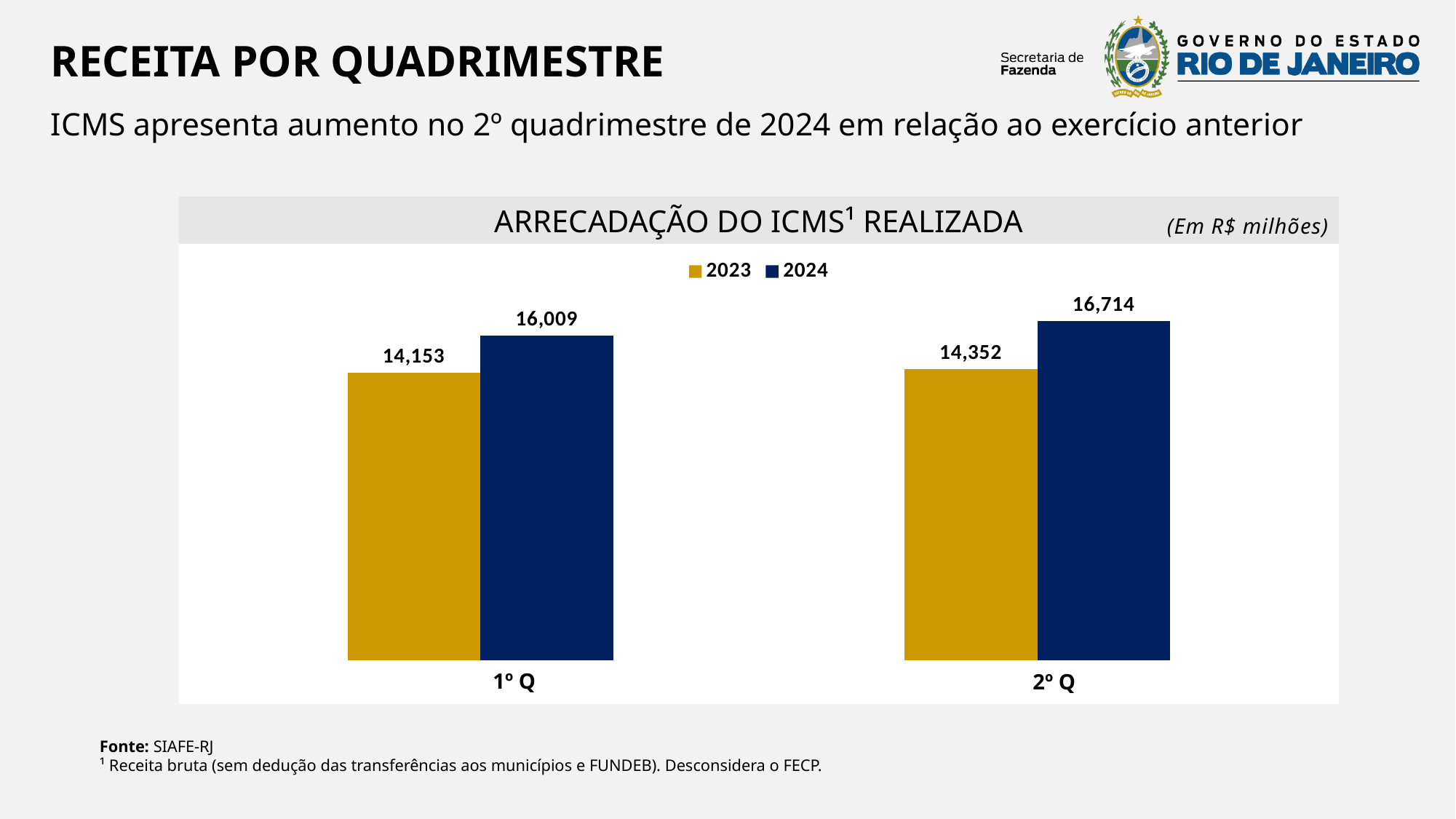
What is the ICMS collection for 2023 in 2º Q? 14,352 What type of chart is shown on the slide? Bar chart What is the ICMS collection for 2023 in 1º Q? 14,153 What is the difference between the 2024 and 2023 values in 2º Q? 2,362 Which is larger in 1º Q, the 2023 value or the 2024 value? 2024 What is the difference between the 2024 and 2023 values in 1º Q? 1,856 Which bar shows the lowest value on the chart? 2023 in 1º Q What is the ICMS collection for 2024 in 2º Q? 16,714 How many series does the legend list? 2 How many quadrimester categories are shown on the x axis? 2 Which bar shows the highest value on the chart? 2024 in 2º Q What is the ICMS collection for 2024 in 1º Q? 16,009